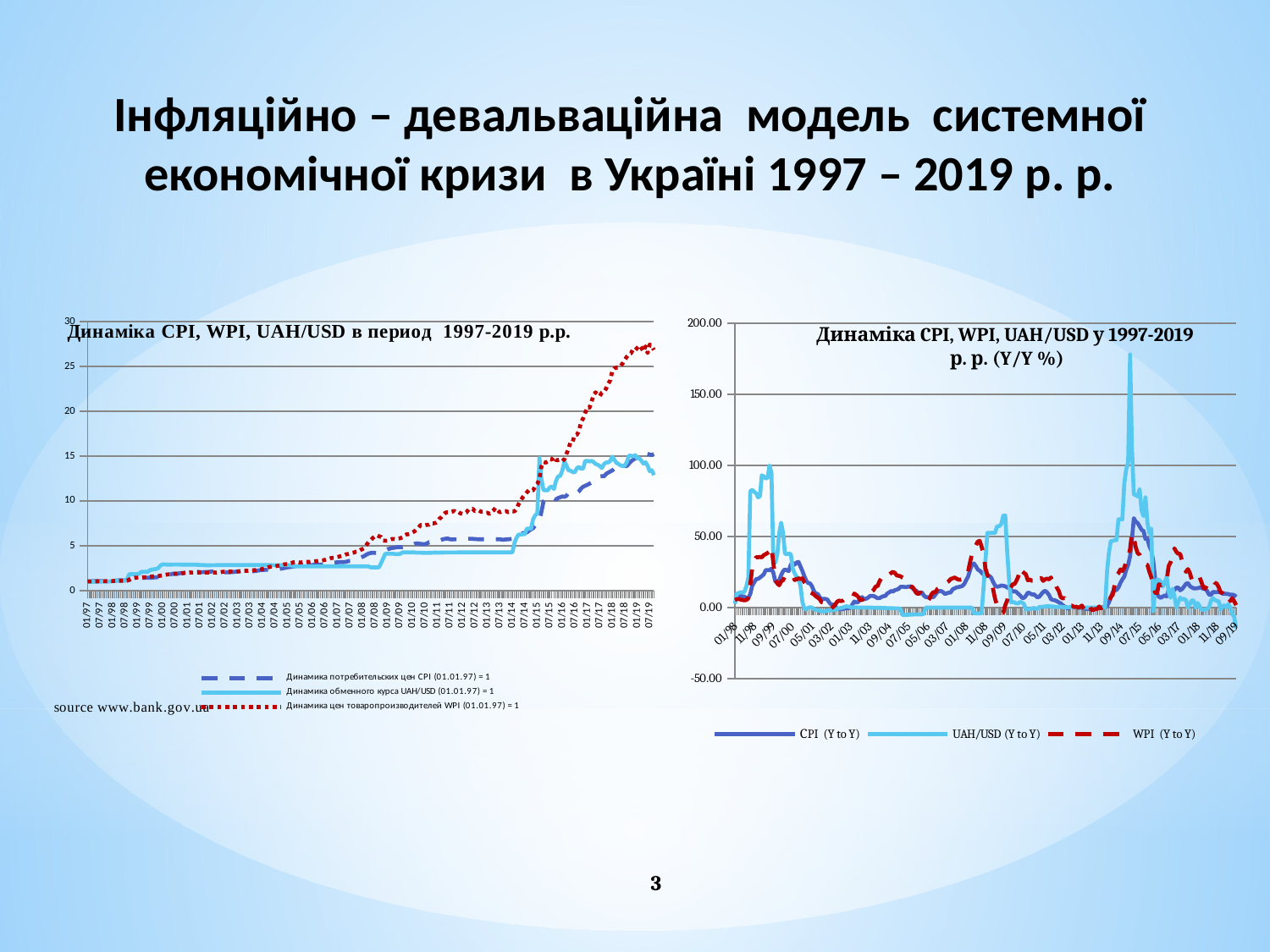
In the right chart, what is the maximum value shown on the vertical axis? 200.00 In the left chart, which series has the highest value at the end of the period (07/19)? WPI (Динамика цен товаропроизводителей WPI) In the left chart, which series is drawn as a dotted red line according to the legend? Динамика цен товаропроизводителей WPI (01.01.97) = 1 In the left chart, does the WPI series generally rise or fall from 01/97 to 07/19? rise What kind of chart is the left chart titled "Динаміка CPI, WPI, UAH/USD в период 1997-2019 р.р."? line chart In the left chart, is the value of the UAH/USD series (solid light blue line) at 01/13 greater or less than 5? less In the right chart, which series reaches the highest peak? UAH/USD (Y to Y) In the right chart, is the peak value of the UAH/USD (Y to Y) series around 2015 greater or less than 150.00? greater What kind of chart is the right chart titled "Динаміка CPI, WPI, UAH/USD у 1997-2019 р. р. (Y/Y %)"? line chart In the left chart, is the value of the WPI series (dotted red line) at the end of the period (07/19) greater or less than 25? greater How many series does the legend of the right chart list? 3 How many series does the legend of the left chart list? 3